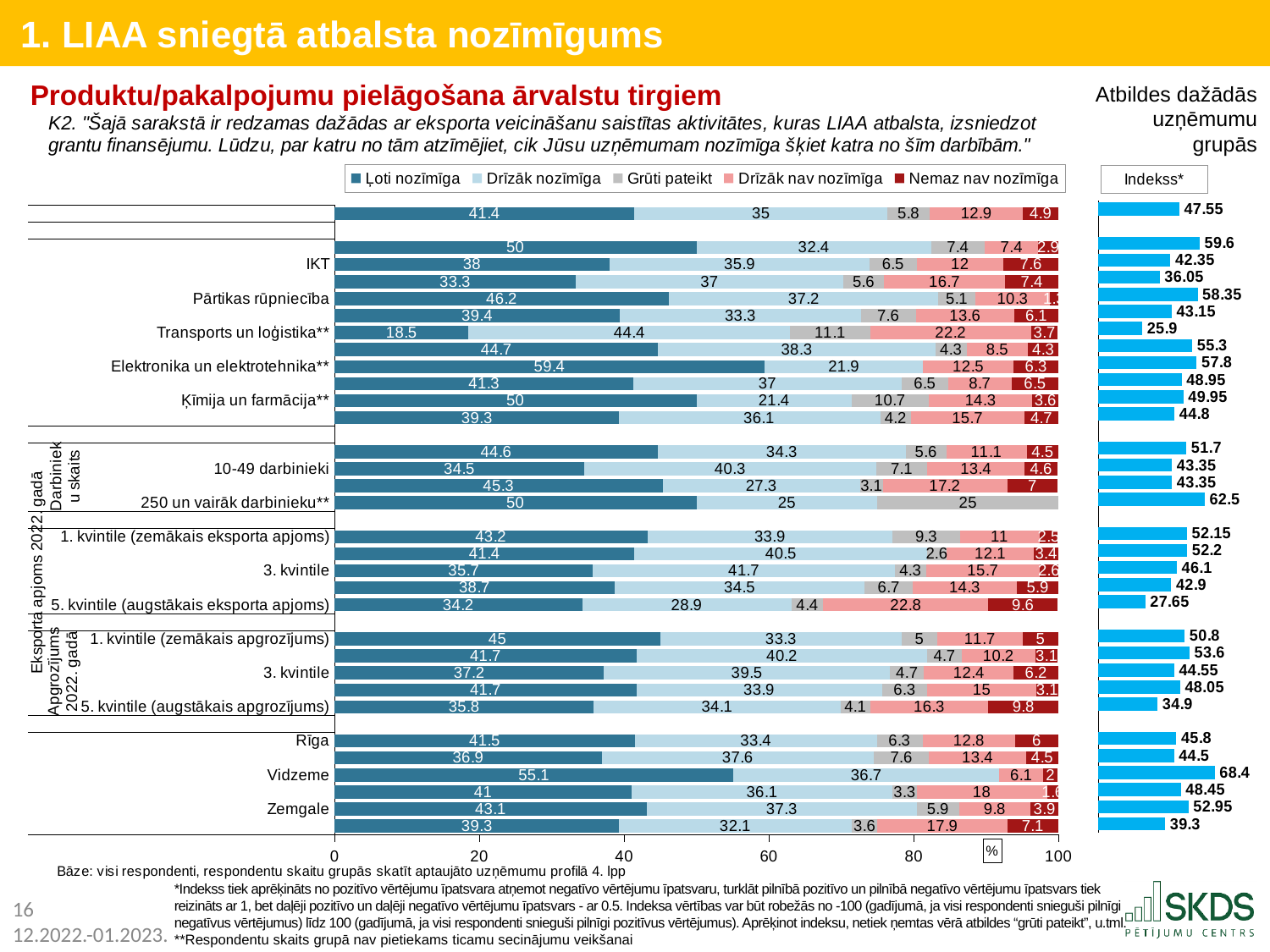
How many series does the legend of the stacked bar chart list? 5 In the 'Indekss*' chart on the right, what is the index value for 'Transports un loģistika**'? 25.9 What kind of chart is the main chart on the slide? Stacked bar chart In the stacked bar chart, what is the difference between the 'Ļoti nozīmīga' values for Zemgale and Rīga? 1.6 In the stacked bar chart, what is the value of 'Ļoti nozīmīga' for Vidzeme? 55.1 In the stacked bar chart, what is the value of 'Drīzāk nav nozīmīga' for '5. kvintile (augstākais eksporta apjoms)'? 22.8 In the stacked bar chart, which has the larger 'Ļoti nozīmīga' value: 'Elektronika un elektrotehnika**' or IKT? Elektronika un elektrotehnika** In the 'Indekss*' chart on the right, which labelled group has the highest index value? Vidzeme In the stacked bar chart, what is the value of 'Nemaz nav nozīmīga' for 'Pārtikas rūpniecība'? 1.3 In the 'Indekss*' chart on the right, what is the index value for Vidzeme? 68.4 In the 'Indekss*' chart on the right, which labelled group has the lowest index value? Transports un loģistika** In the stacked bar chart, what is the value of 'Grūti pateikt' for '250 un vairāk darbinieku**'? 25